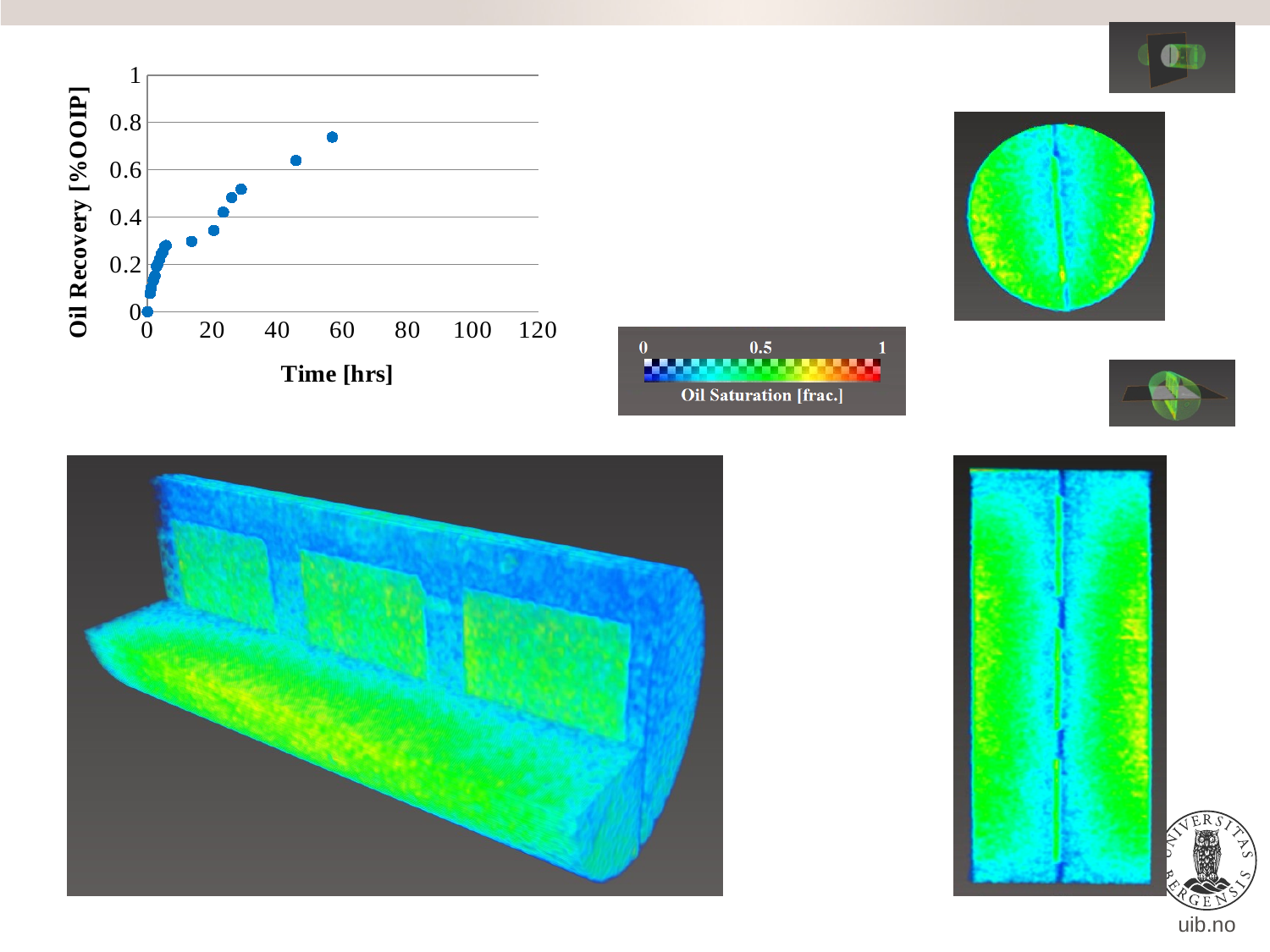
In the top-left chart, is the time of the rightmost (latest) point greater or less than 60 hrs? less In the top-left chart, is the oil recovery of the first point (at time 0) greater or less than 0.2? less In the top-left chart, does any point reach an oil recovery greater than 0.8? no In the top-left chart, which point has the highest oil recovery: the one at about 20 hrs or the one at about 57 hrs? the one at about 57 hrs What is the y-axis title of the top-left chart? Oil Recovery [%OOIP] What kind of chart is shown in the top-left of the slide? scatter chart In the top-left chart, does oil recovery rise or fall as time increases? rise What is the x-axis title of the top-left chart? Time [hrs]